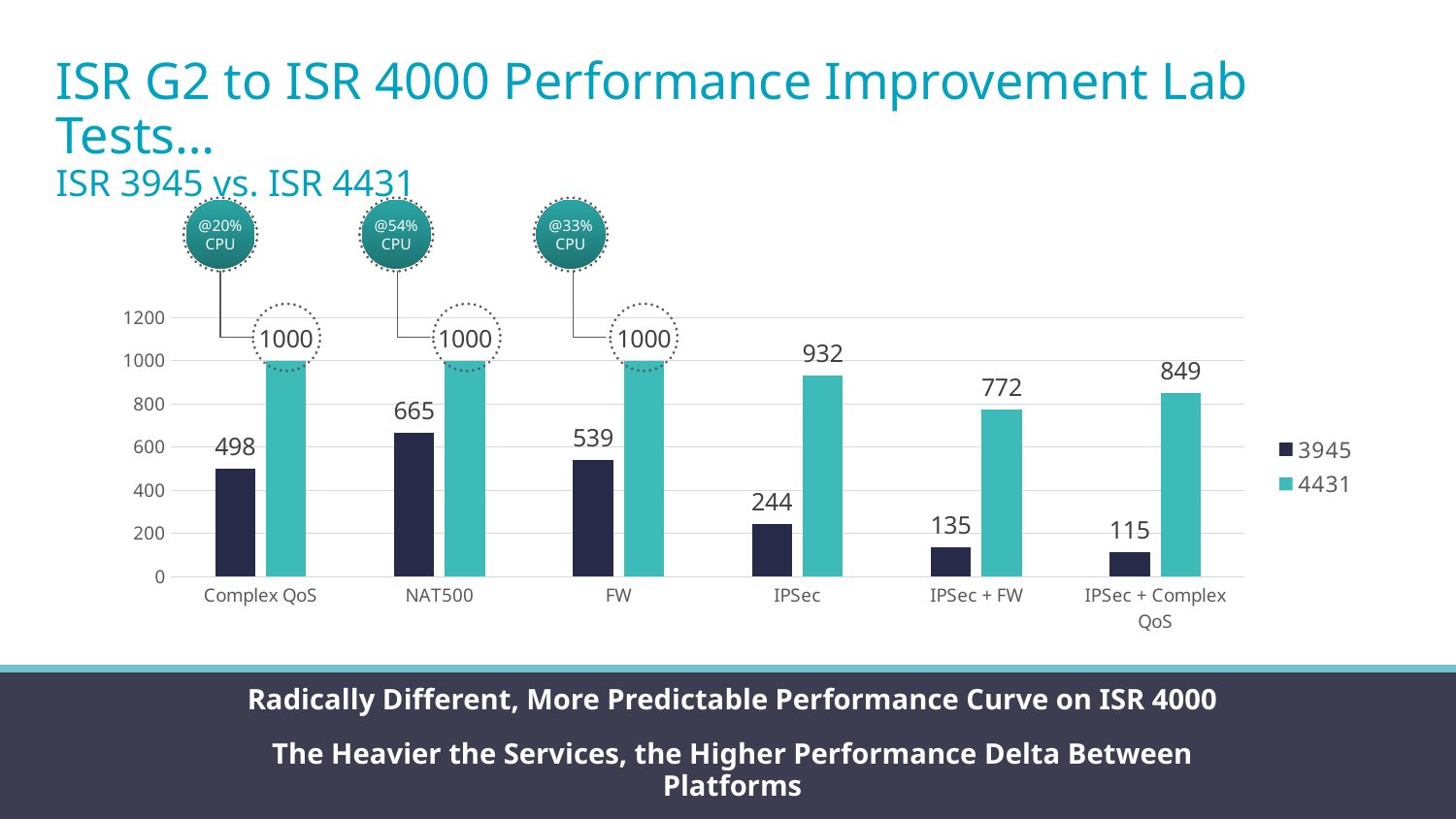
Is the value for 4431 in the IPSec + FW category greater or less than 600? greater Which category has the lowest value for the 3945 series? IPSec + Complex QoS What kind of chart is shown on the slide? bar chart What is the difference between the 4431 and 3945 values in the IPSec + Complex QoS category? 734 How many categories are shown on the x axis? 6 How many series does the legend list? 2 What is the value for 3945 in the Complex QoS category? 498 What is the value for 3945 in the IPSec + FW category? 135 Which category has the highest value for the 3945 series? NAT500 Which is larger in the FW category, the 3945 value or the 4431 value? 4431 What is the value for 4431 in the IPSec category? 932 What CPU percentage is annotated above the NAT500 category? @54% CPU